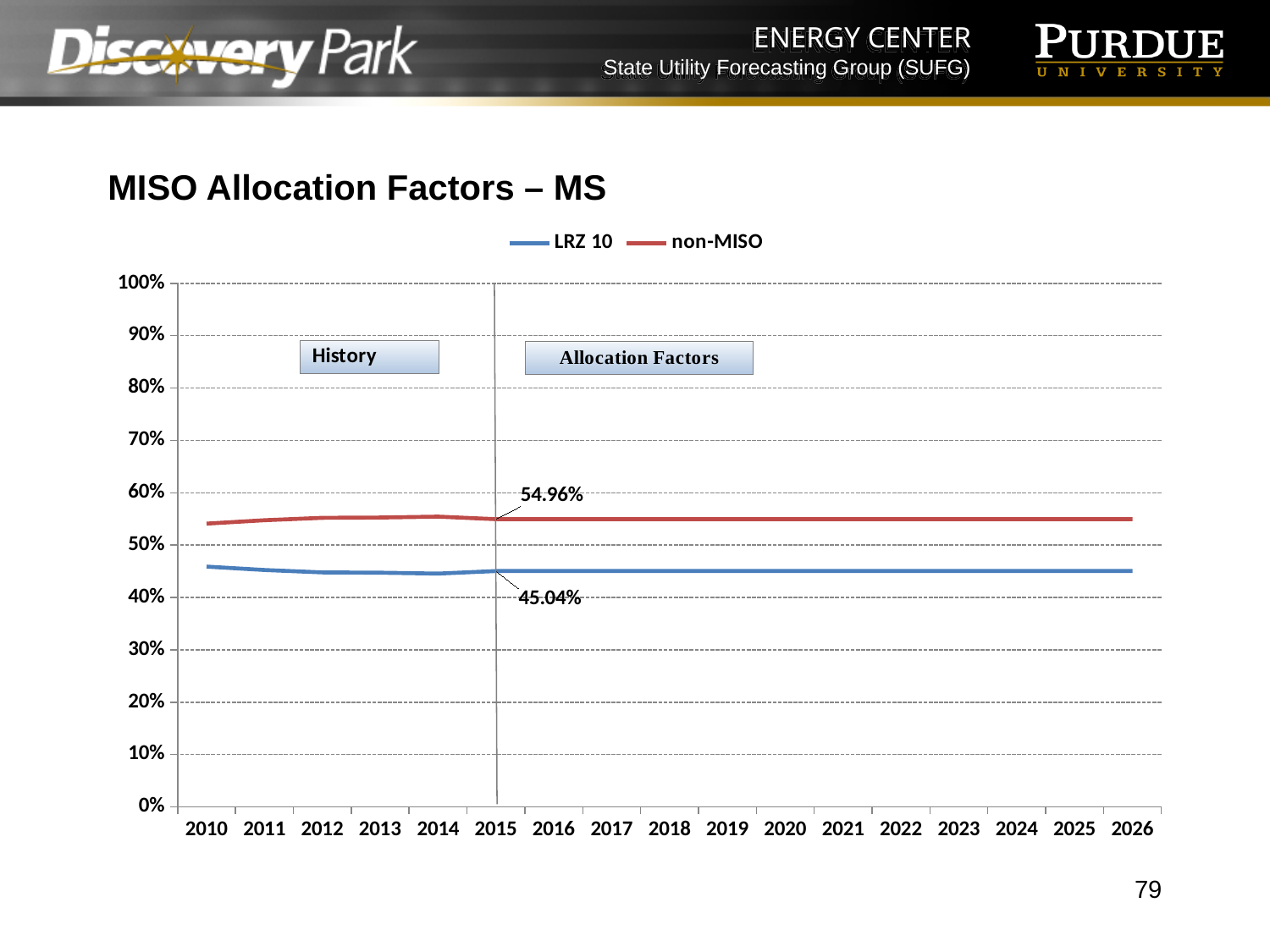
What is the difference between the non-MISO and LRZ 10 values in 2015? 9.92% Is the value for LRZ 10 in 2010 greater or less than 50%? less Is the value for non-MISO in 2020 greater or less than 50%? greater What kind of chart is shown on the slide? line chart What is the title of the slide's chart? MISO Allocation Factors – MS Does the LRZ 10 line rise, fall, or stay flat from 2016 to 2026? stays flat How many series does the legend list? 2 Is the value for non-MISO in 2014 greater or less than 60%? less In 2015, which series has the larger value, LRZ 10 or non-MISO? non-MISO How many years are shown on the x axis? 17 What is the value of the non-MISO series in 2015? 54.96% What is the value of the LRZ 10 series in 2015? 45.04%